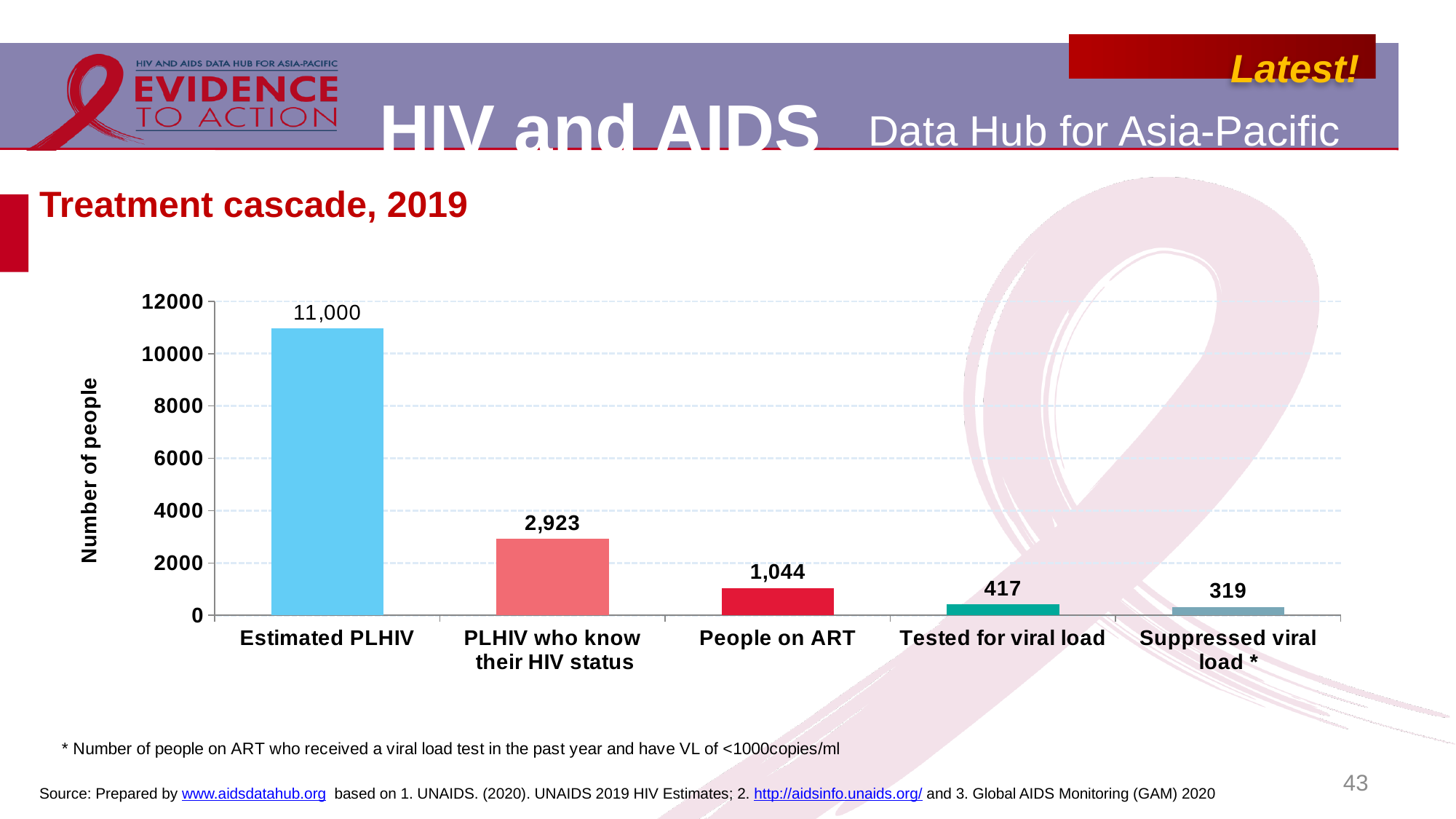
Which category has the lowest value? Suppressed viral load Which is larger, People on ART or Tested for viral load? People on ART What is the difference between Tested for viral load and Suppressed viral load? 98 Do the values rise or fall from left to right along the x axis? fall What is the value for Estimated PLHIV? 11,000 What is the value for PLHIV who know their HIV status? 2,923 What is the difference between Estimated PLHIV and PLHIV who know their HIV status? 8,077 What is the value for Tested for viral load? 417 What is the value for People on ART? 1,044 What is the value for Suppressed viral load? 319 How many categories are shown on the x axis? 5 Which category has the highest value? Estimated PLHIV